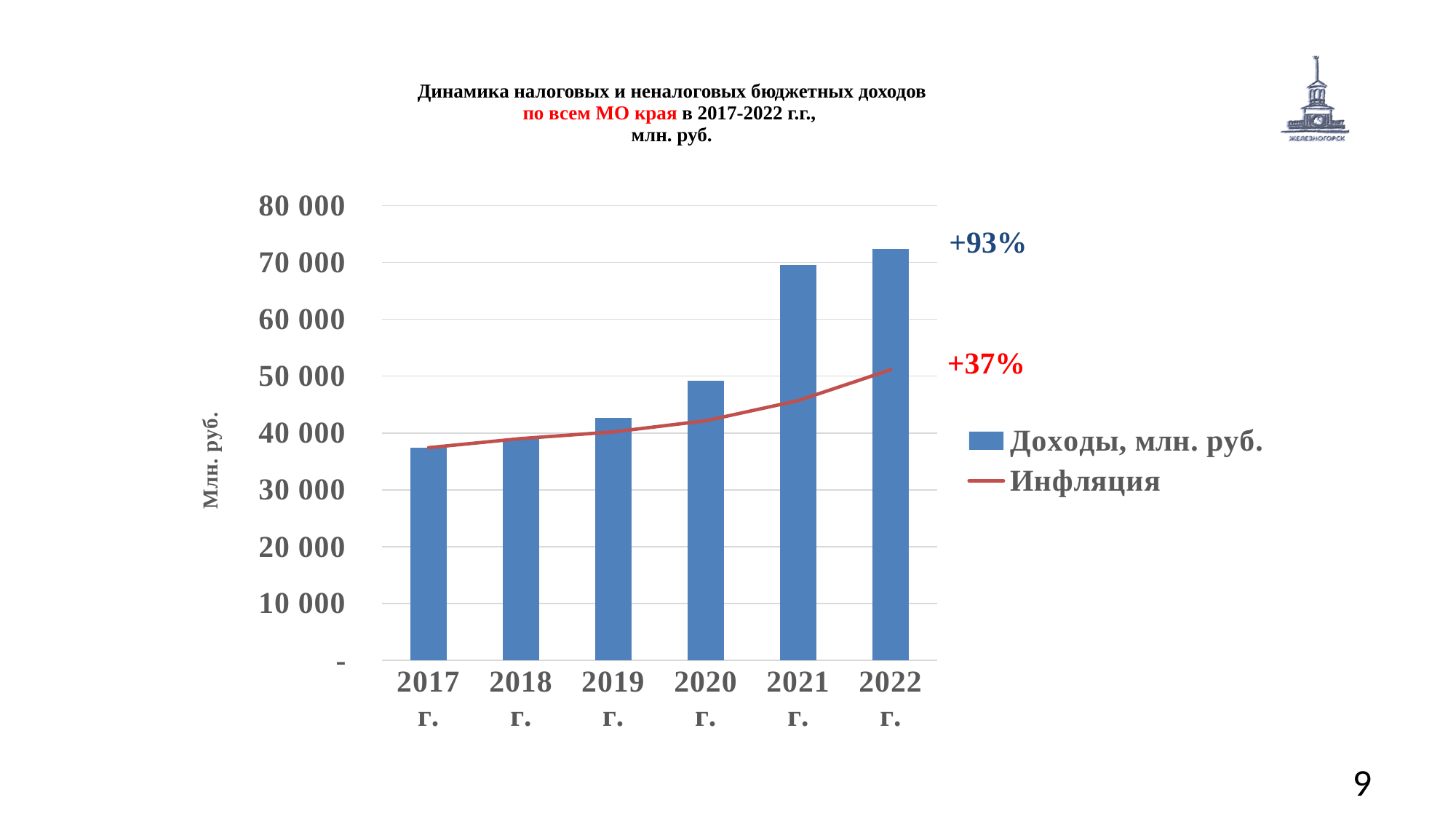
How many series does the chart legend list? 2 What kind of chart is shown on the slide? Bar chart with a line What percentage growth is annotated next to the Доходы bars at the right of the chart? +93% Is the value for Доходы in 2021 г. greater or less than 60 000? greater Is the value for Доходы in 2017 г. greater or less than 40 000? less Do the Доходы bars rise or fall from 2017 to 2022? Rise Is the value for Доходы in 2022 г. greater or less than 70 000? greater Which year has the larger Доходы bar, 2020 г. or 2021 г.? 2021 г. Which year has the highest bar for Доходы, млн. руб.? 2022 г. Which year has the lowest bar for Доходы, млн. руб.? 2017 г. How many years are shown on the x axis of the chart? 6 What percentage is annotated at the end of the Инфляция line? +37%